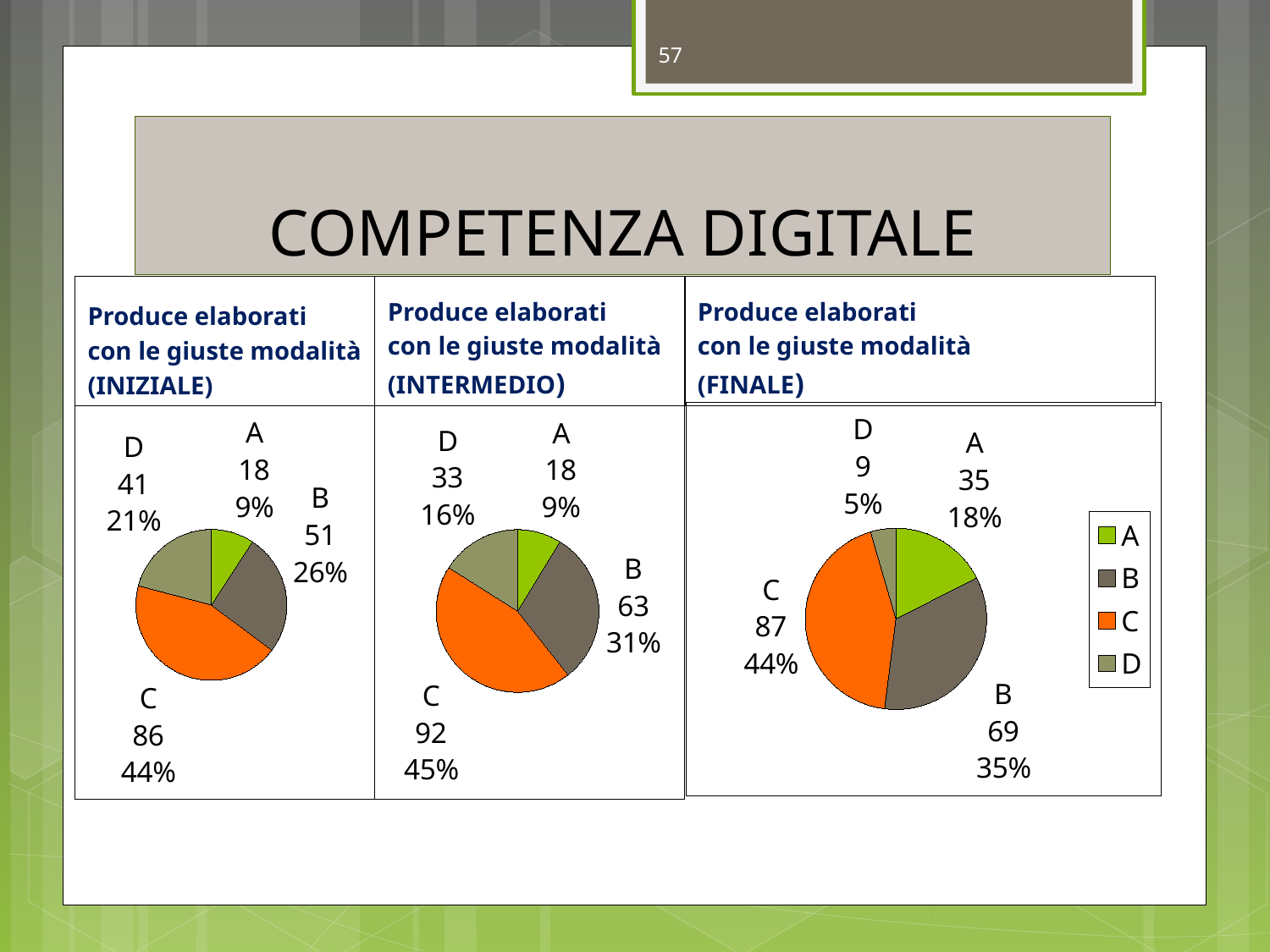
In the FINALE pie chart, what is the value for category D? 9 Which colour represents category C in the pie charts? Orange How many entries does the legend next to the FINALE chart list? 4 In the FINALE pie chart, what percentage share does category A have? 18% In the INIZIALE pie chart, which category has the smallest slice? A How many categories does the INIZIALE pie chart show? 4 In the INTERMEDIO pie chart, what is the difference between the values for C and B? 29 In the INTERMEDIO pie chart, what percentage share does category B have? 31% In the INIZIALE pie chart, what is the value for category C? 86 What kind of chart is used for the INTERMEDIO data? Pie chart In the FINALE pie chart, which is larger, the value for A or the value for D? A In the FINALE pie chart, which category has the largest slice? C